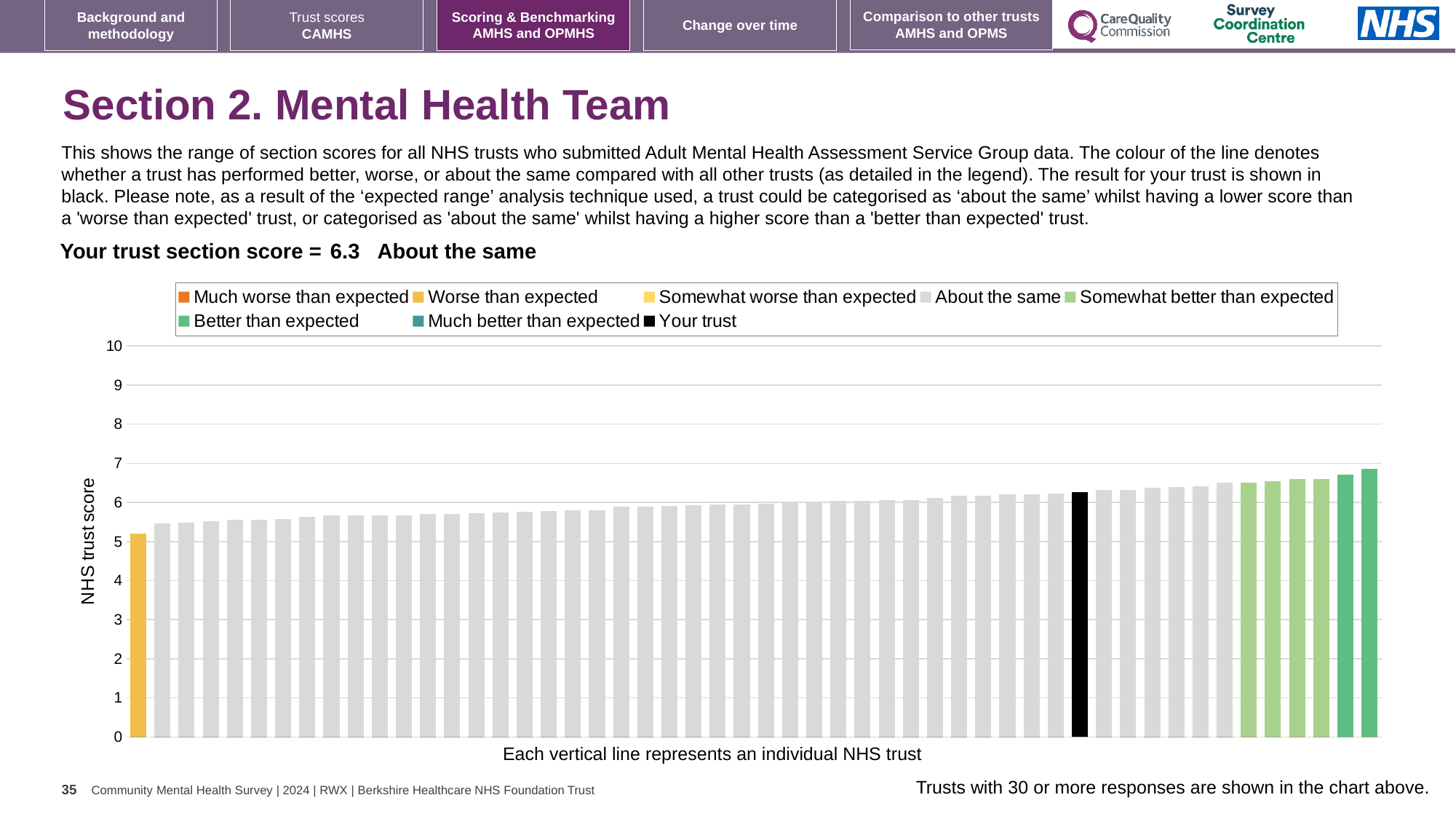
Which category is your trust's section score placed in? About the same What is the highest tick value shown on the vertical axis? 10 Is the value of the lowest (leftmost) bar greater or less than 5? greater What is the label of the vertical axis? NHS trust score Is the value of the black 'Your trust' bar greater or less than 6? greater How many entries does the chart legend list? 8 Do the bar values rise or fall from left to right across the chart? rise What is the section score for your trust shown on the slide? 6.3 Is the value of the lowest (leftmost) bar greater or less than 6? less What colour does the legend use for 'Your trust'? black What kind of chart is shown on the slide? bar chart